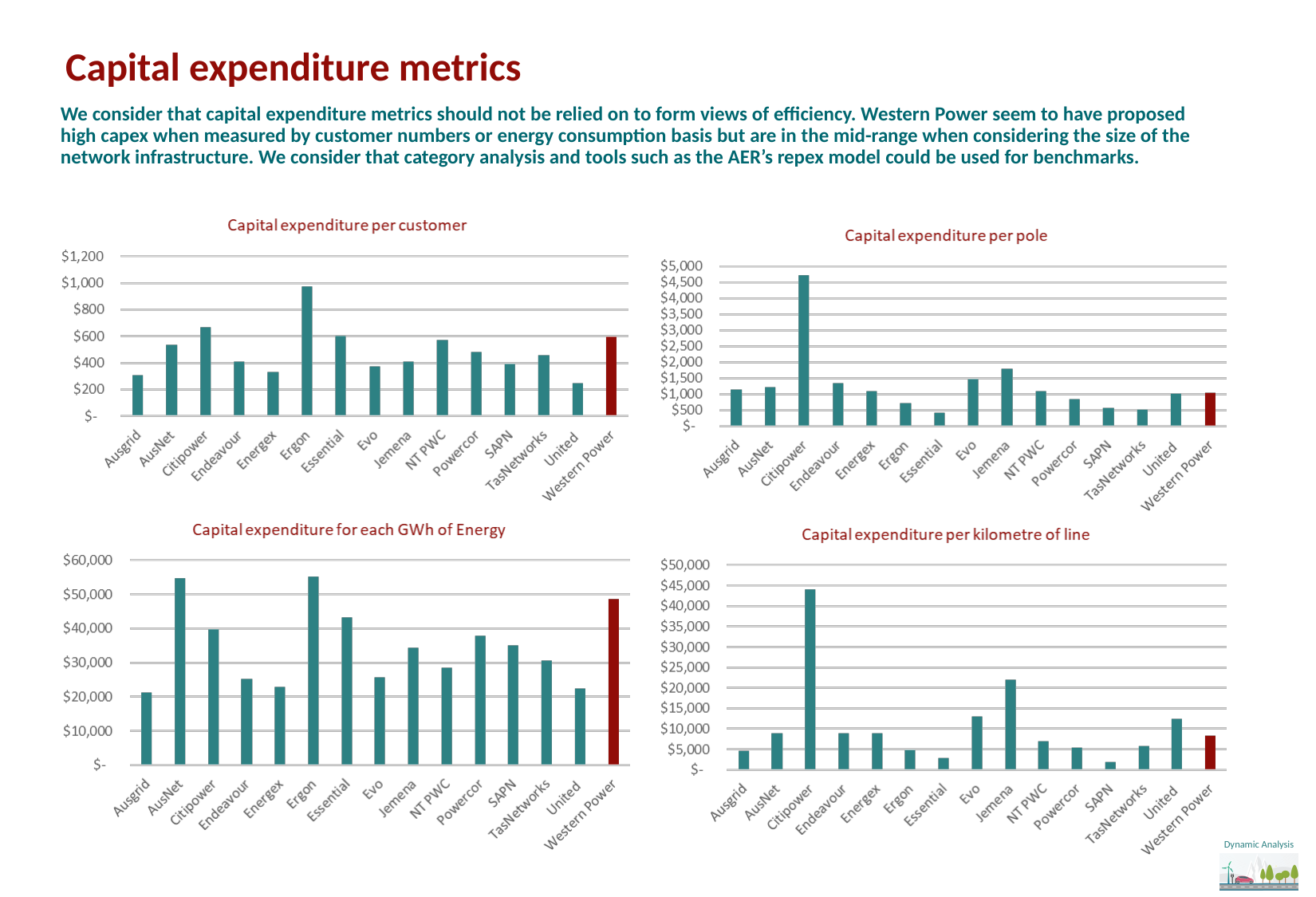
In the 'Capital expenditure per pole' chart, which category has the lowest value? Essential In the 'Capital expenditure per customer' chart, is the value for Western Power greater or less than $400? greater In the 'Capital expenditure per kilometre of line' chart, which category has the highest value? Citipower In the 'Capital expenditure per kilometre of line' chart, which category has the lowest value? SAPN How many categories are shown in the 'Capital expenditure per customer' chart? 15 In the 'Capital expenditure for each GWh of Energy' chart, is the value for Western Power greater or less than $40,000? greater In the 'Capital expenditure per kilometre of line' chart, which is larger, Jemena or Evo? Jemena In the 'Capital expenditure per customer' chart, which is larger, Citipower or AusNet? Citipower In the 'Capital expenditure per pole' chart, is the value for Citipower greater or less than $4,000? greater In the 'Capital expenditure per pole' chart, which category has the highest value? Citipower In the 'Capital expenditure per customer' chart, which category has the lowest value? United In the 'Capital expenditure per customer' chart, which category has the highest value? Ergon